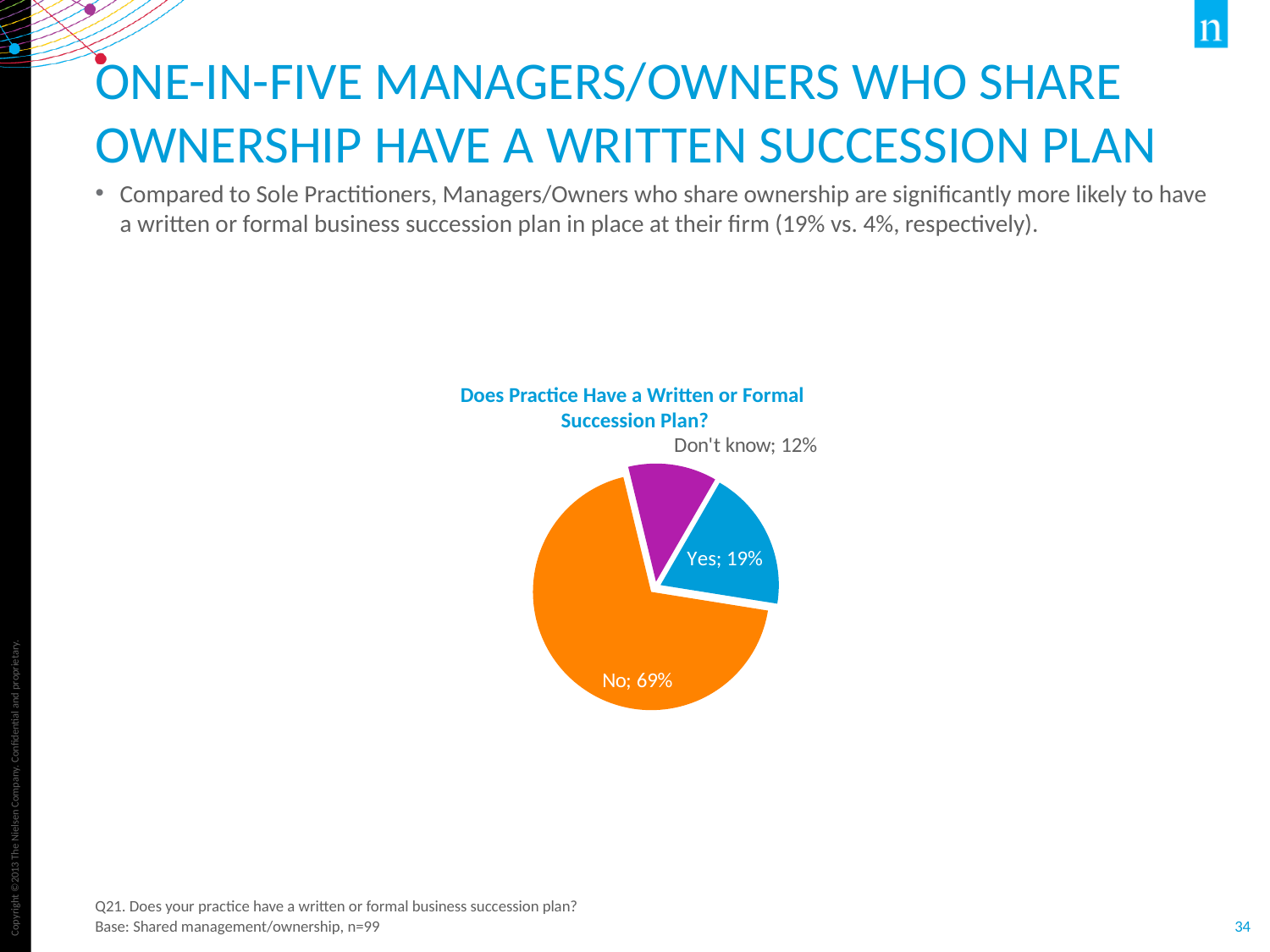
What kind of chart is shown on the slide? Pie chart What is the combined share of the "Yes" and "Don't know" slices? 31% Which response has the smallest share of the pie? Don't know What percentage of respondents answered "Don't know"? 12% What percentage of respondents answered "No"? 69% What percentage of respondents answered "Yes"? 19% What is the difference in percentage points between the "No" and "Yes" slices? 50 Which is larger, the "Yes" slice or the "Don't know" slice? Yes What is the title of the chart? Does Practice Have a Written or Formal Succession Plan? Which response has the largest share of the pie? No How many slices does the pie chart have? 3 What colour is the "No" slice of the pie? Orange